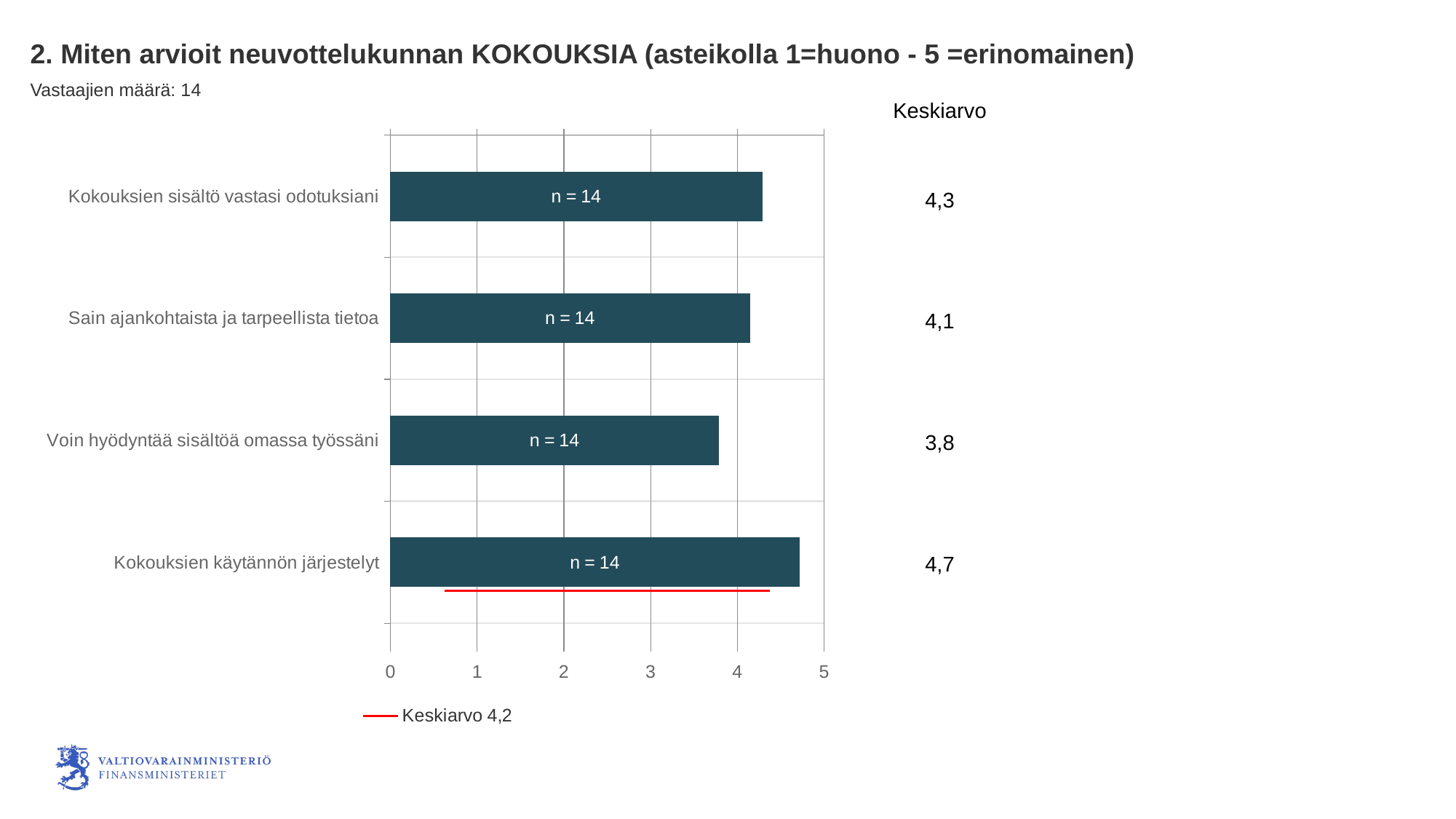
What overall average (Keskiarvo) does the red line in the legend indicate? 4,2 What is the average value for "Voin hyödyntää sisältöä omassa työssäni"? 3,8 Is the value for "Voin hyödyntää sisältöä omassa työssäni" greater or less than 4? less What is the average (Keskiarvo) value for "Kokouksien sisältö vastasi odotuksiani"? 4,3 What kind of chart is shown on the slide? Bar chart How many categories are shown in the chart? 4 Which has a higher average value: "Kokouksien sisältö vastasi odotuksiani" or "Sain ajankohtaista ja tarpeellista tietoa"? Kokouksien sisältö vastasi odotuksiani Which category has the highest average value? Kokouksien käytännön järjestelyt Which category has the lowest average value? Voin hyödyntää sisältöä omassa työssäni What is the average value for "Sain ajankohtaista ja tarpeellista tietoa"? 4,1 What is the difference between the average values for "Kokouksien käytännön järjestelyt" and "Voin hyödyntää sisältöä omassa työssäni"? 0,9 What is the average value for "Kokouksien käytännön järjestelyt"? 4,7